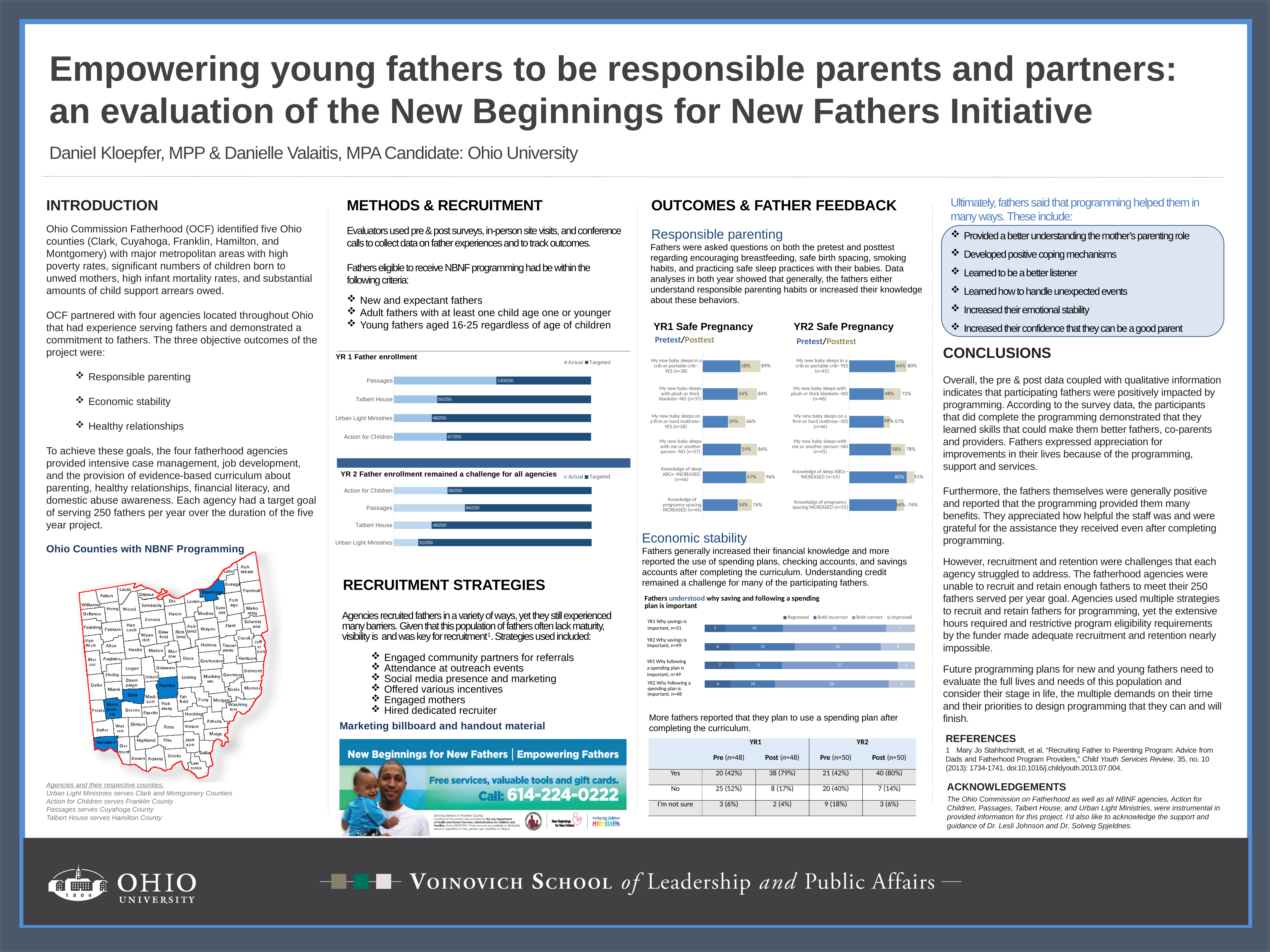
In the YR 1 Father enrollment chart, what is the actual enrollment label shown for Passages? 130/250 In the YR 1 Father enrollment chart, which agency has the lowest actual enrollment? Urban Light Ministries In the YR2 Safe Pregnancy chart, what is the pretest value for 'Knowledge of sleep ABCs--INCREASED'? 80% In the YR1 Safe Pregnancy chart, what is the posttest value for 'Knowledge of sleep ABCs--INCREASED'? 96% In the 'Fathers understood why saving and following a spending plan is important' chart, what is the 'Both correct' value for 'YR1 Why following a spending plan is important, n=49'? 27 In the 'Fathers understood why saving and following a spending plan is important' chart, what is the total of the stacked bar for 'YR1 Why savings is important, n=51'? 51 In the YR 2 Father enrollment chart, which agency has the highest actual enrollment? Passages In the YR1 Safe Pregnancy chart, what is the difference between the pretest and posttest values for 'My new baby sleeps in a crib or portable crib--YES'? 31% What kind of chart is the YR 2 Father enrollment chart? bar chart In the YR 1 Father enrollment chart, how many series does the legend list? 2 In the YR 2 Father enrollment chart, what is the actual enrollment label shown for Urban Light Ministries? 31/250 In the YR 1 Father enrollment chart, how many agencies are listed? 4